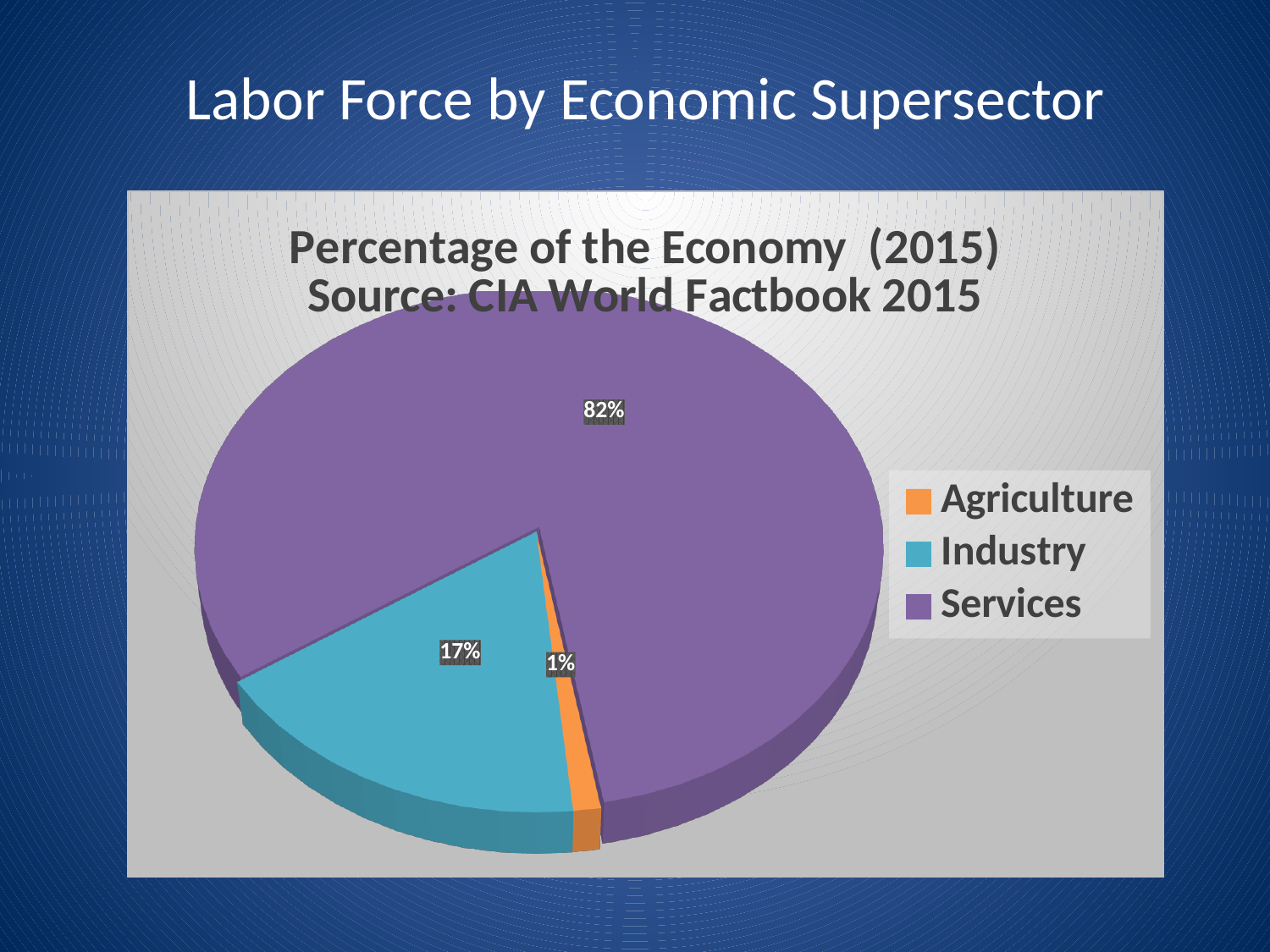
Which sector has the smallest share of the pie? Agriculture What percentage of the labor force is in Agriculture? 1% How many sectors are shown in the pie chart? 3 Which sector has the largest share of the pie? Services What is the difference in percentage points between Services and Industry? 65 What percentage of the labor force is in Industry? 17% What kind of chart is shown on the slide? Pie chart Which is larger, the share for Industry or the share for Agriculture? Industry What is the difference in percentage points between Industry and Agriculture? 16 What is the title of the chart? Percentage of the Economy (2015) Source: CIA World Factbook 2015 What colour is the Services slice? Purple What percentage of the labor force is in Services? 82%